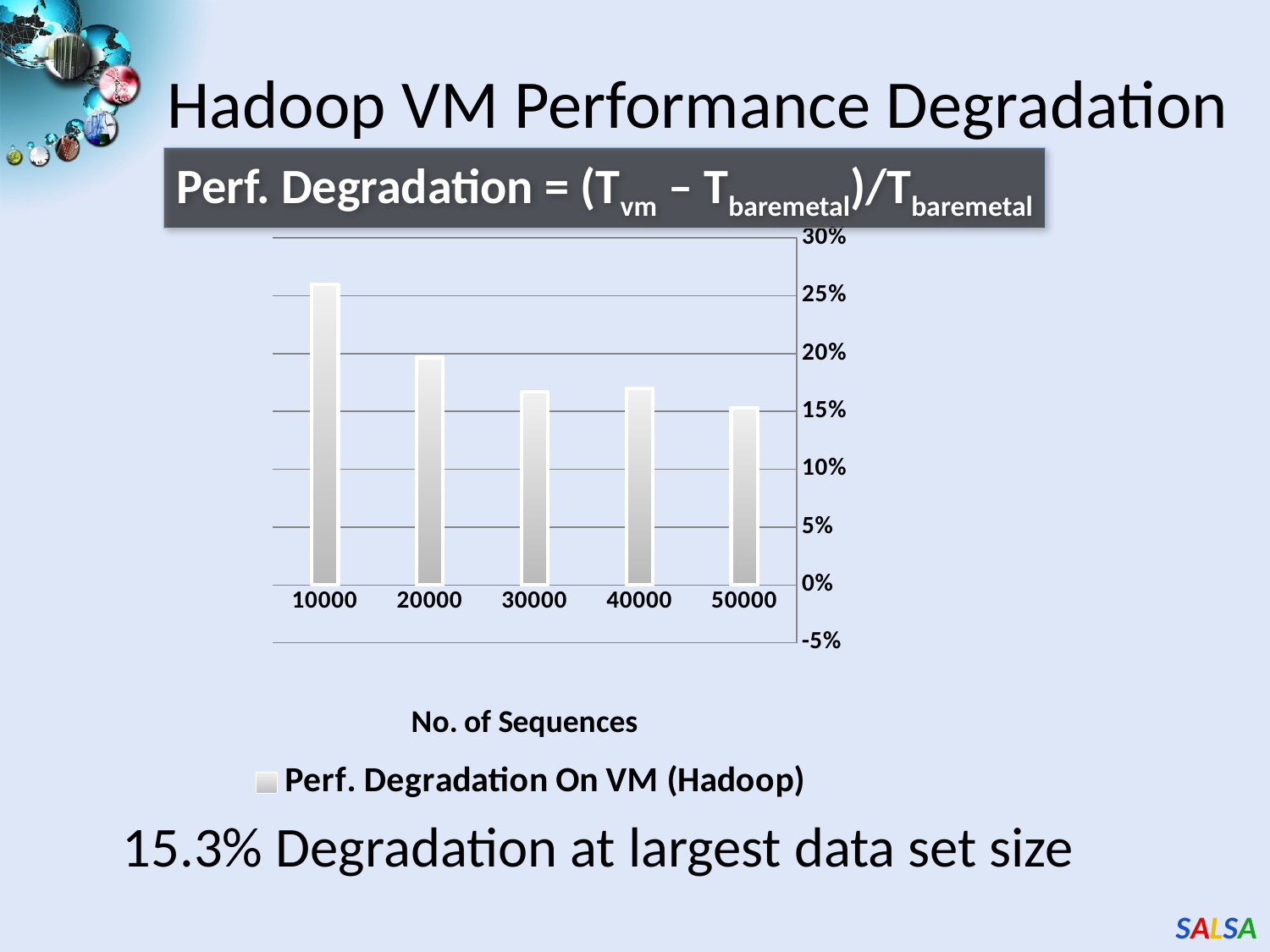
What kind of chart is shown on the slide? bar chart What is the series name shown in the legend? Perf. Degradation On VM (Hadoop) How many categories (numbers of sequences) are plotted on the x axis? 5 How many series does the legend list? 1 Do the performance degradation values generally rise or fall as the number of sequences increases? fall Which has the larger performance degradation, 10000 sequences or 20000 sequences? 10000 Which number of sequences has the highest performance degradation? 10000 Which number of sequences has the lowest performance degradation? 50000 Is the value for 10000 sequences greater or less than 25%? greater What is the x-axis title of the chart? No. of Sequences Is the value for 30000 sequences greater or less than 15%? greater